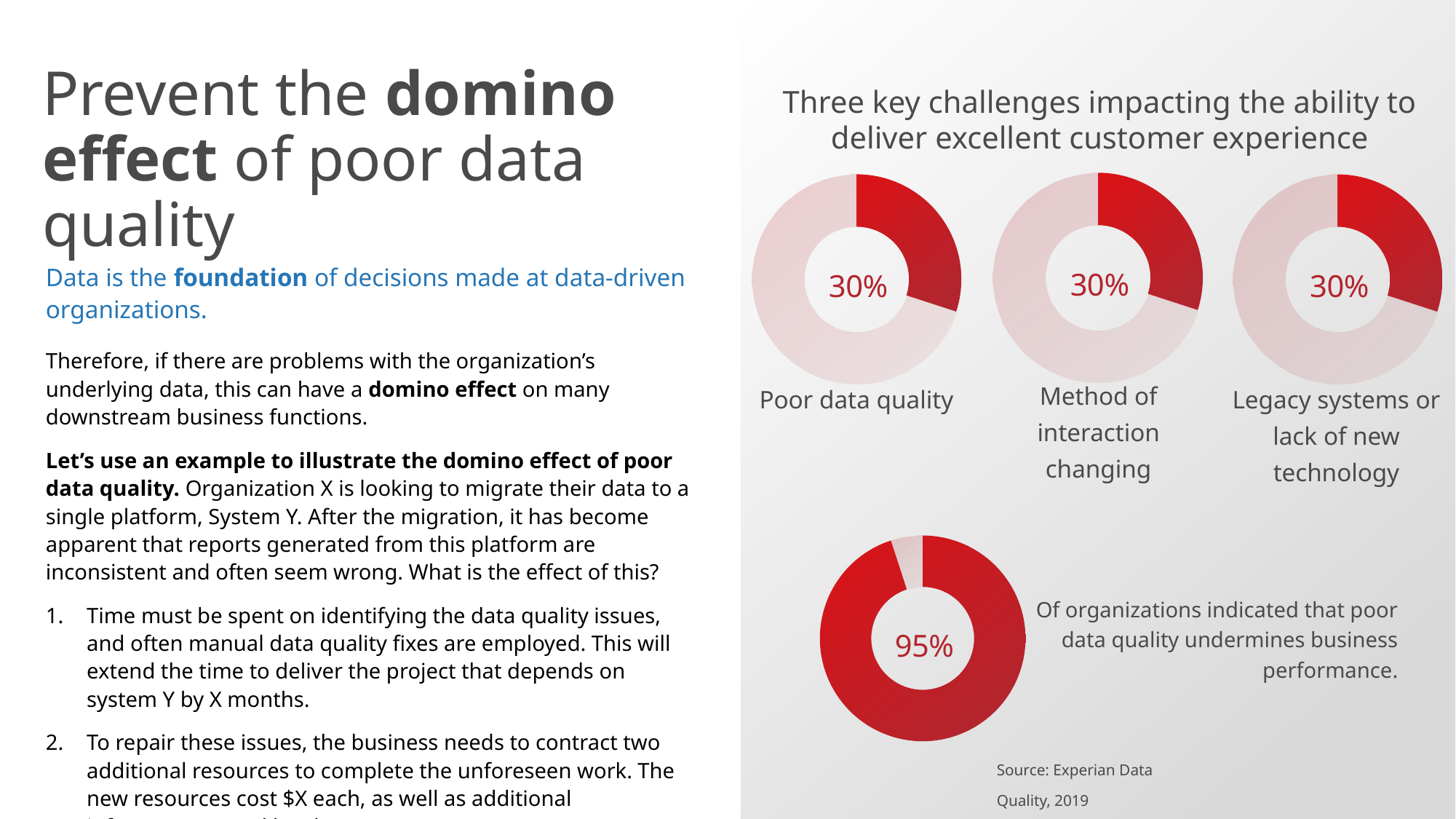
How many donut charts are shown under the heading 'Three key challenges impacting the ability to deliver excellent customer experience'? 3 What is the title above the three donut charts? Three key challenges impacting the ability to deliver excellent customer experience What is the source cited for the charts on the slide? Experian Data Quality, 2019 Is the value in the bottom donut chart greater or less than 50%? greater In the 'Poor data quality' donut chart, what percentage is shown? 30% In the 'Legacy systems or lack of new technology' donut chart, what percentage is shown? 30% What kind of chart is used to show the 95% value at the bottom of the slide? Donut chart Which value is larger: the bottom donut chart's 95% or the 'Poor data quality' donut chart's value? The bottom donut chart (95%) Is the value in the 'Method of interaction changing' donut chart greater or less than 50%? less In the 'Method of interaction changing' donut chart, what percentage is shown? 30% In the bottom donut chart, what percentage of organizations indicated that poor data quality undermines business performance? 95% What is the difference between the bottom donut chart's value and the 'Legacy systems or lack of new technology' donut chart's value? 65%